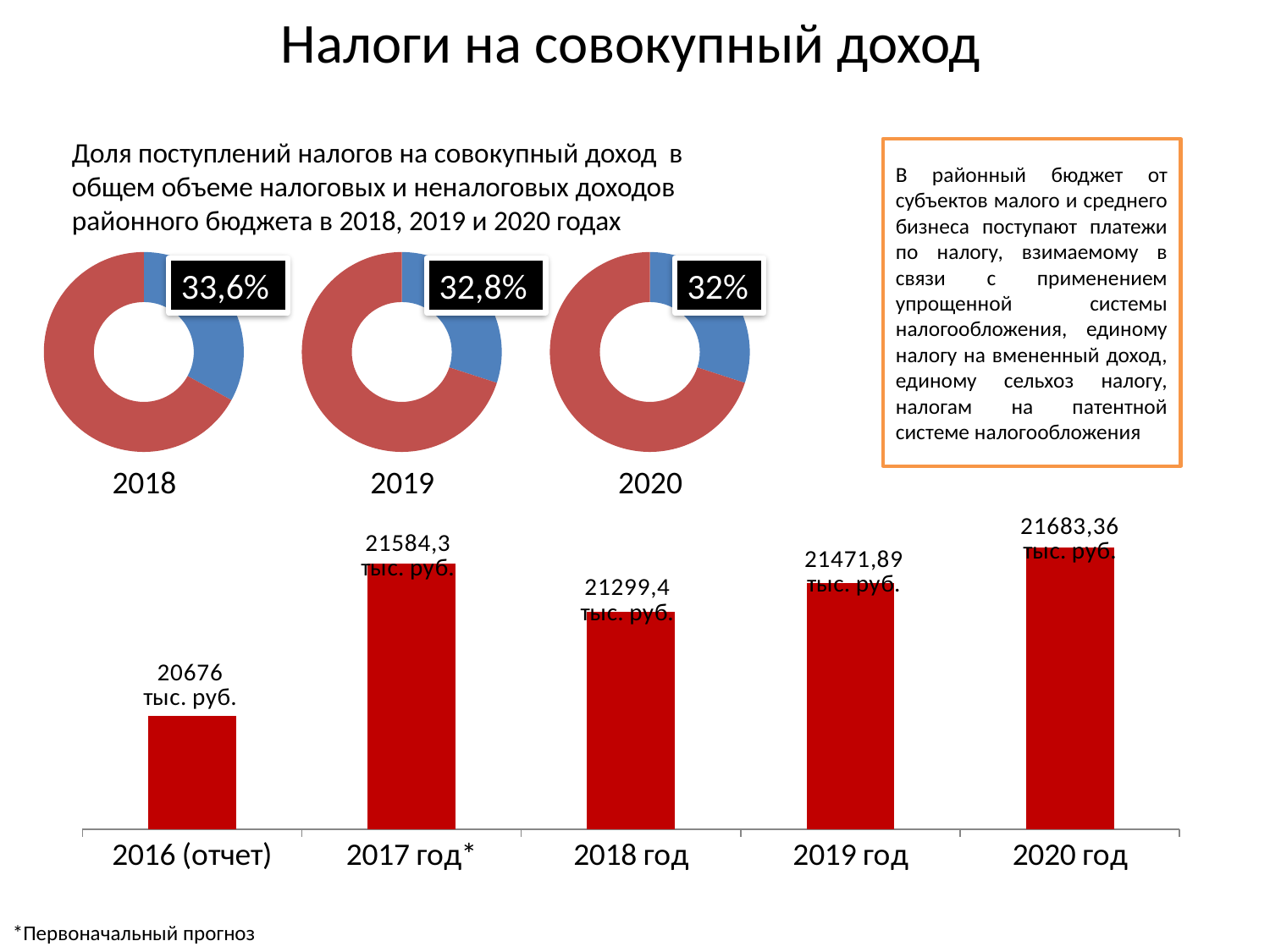
What kind of chart is shown at the bottom of the slide? Bar chart How many bars are in the bar chart at the bottom of the slide? 5 In the bar chart at the bottom of the slide, what is the value for 2018 год? 21299,4 тыс. руб. In the bar chart at the bottom of the slide, which category has the highest value? 2020 год In the donut chart labelled 2020, what share is shown by the data label? 32% Across the three donut charts for 2018, 2019 and 2020, does the labelled share rise or fall from year to year? Fall In the bar chart at the bottom of the slide, what is the value for 2020 год? 21683,36 тыс. руб. In the donut chart labelled 2018, what share is shown by the data label? 33,6% In the bar chart at the bottom of the slide, what is the value for 2016 (отчет)? 20676 тыс. руб. In the bar chart at the bottom of the slide, what is the difference between the values for 2017 год* and 2018 год? 284,9 тыс. руб. In the bar chart at the bottom of the slide, which is larger: the value for 2019 год or the value for 2018 год? 2019 год In the bar chart at the bottom of the slide, which category has the lowest value? 2016 (отчет)